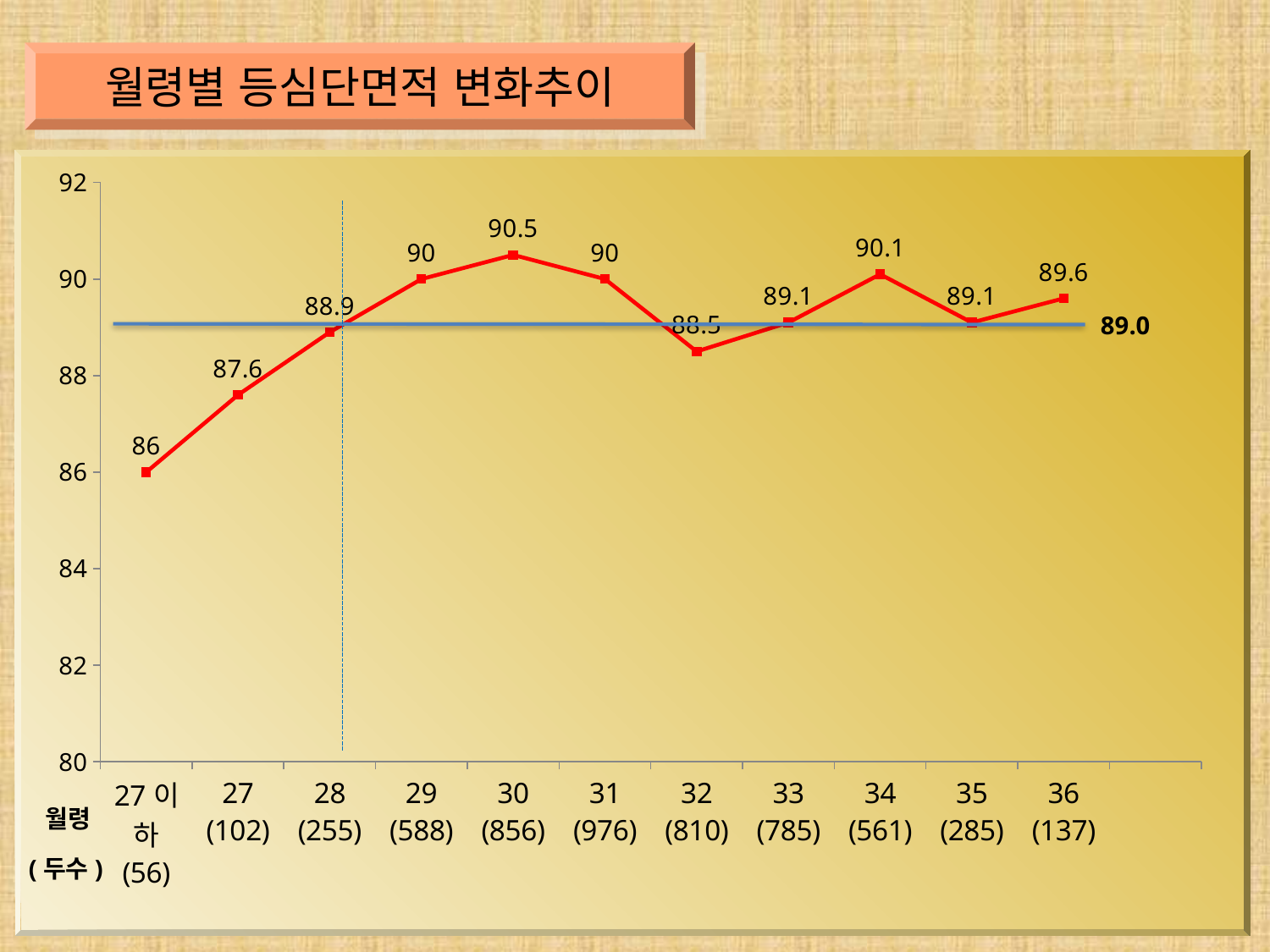
What is the difference between the values for month 30 and month 32? 2 What is the value plotted for the category 27 이하 (56)? 86 How many month categories are plotted on the x axis? 11 What is the value plotted for month 30 (856)? 90.5 Which month category has the highest plotted value? 30 (856) Which has a larger value, month 28 or month 36? 36 What value does the horizontal reference line mark? 89.0 What is the value plotted for month 34 (561)? 90.1 Which month category has the lowest plotted value? 27 이하 (56) Does the plotted value rise or fall from month 27 이하 to month 30? Rise What type of chart is shown on the slide? Line chart What is the title of the chart? 월령별 등심단면적 변화추이